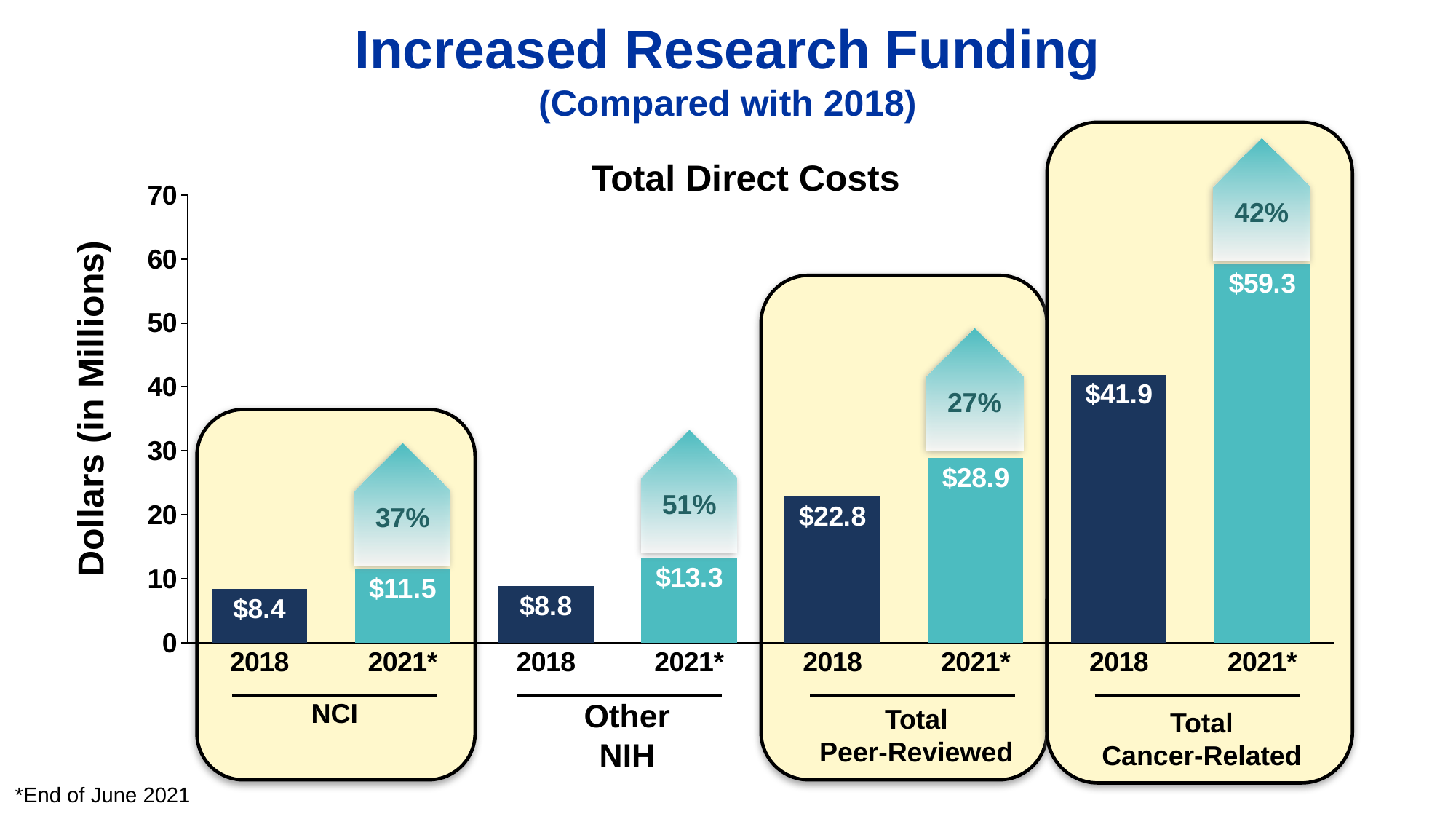
What is the difference between the 2021* and 2018 values for Total Peer-Reviewed? $6.1 What kind of chart is this? bar chart Which category has the lowest 2018 value? NCI Which category has the highest 2021* value? Total Cancer-Related What is the 2021* value for Other NIH? $13.3 What percentage increase is shown for Total Peer-Reviewed? 27% Which is larger, the 2021* value for NCI or the 2021* value for Other NIH? Other NIH Is the 2018 value for Total Cancer-Related greater or less than 40? greater What is the 2018 value for NCI? $8.4 What is the y-axis label of the chart? Dollars (in Millions) How many categories are shown on the x axis? 4 What is the 2021* value for Total Cancer-Related? $59.3